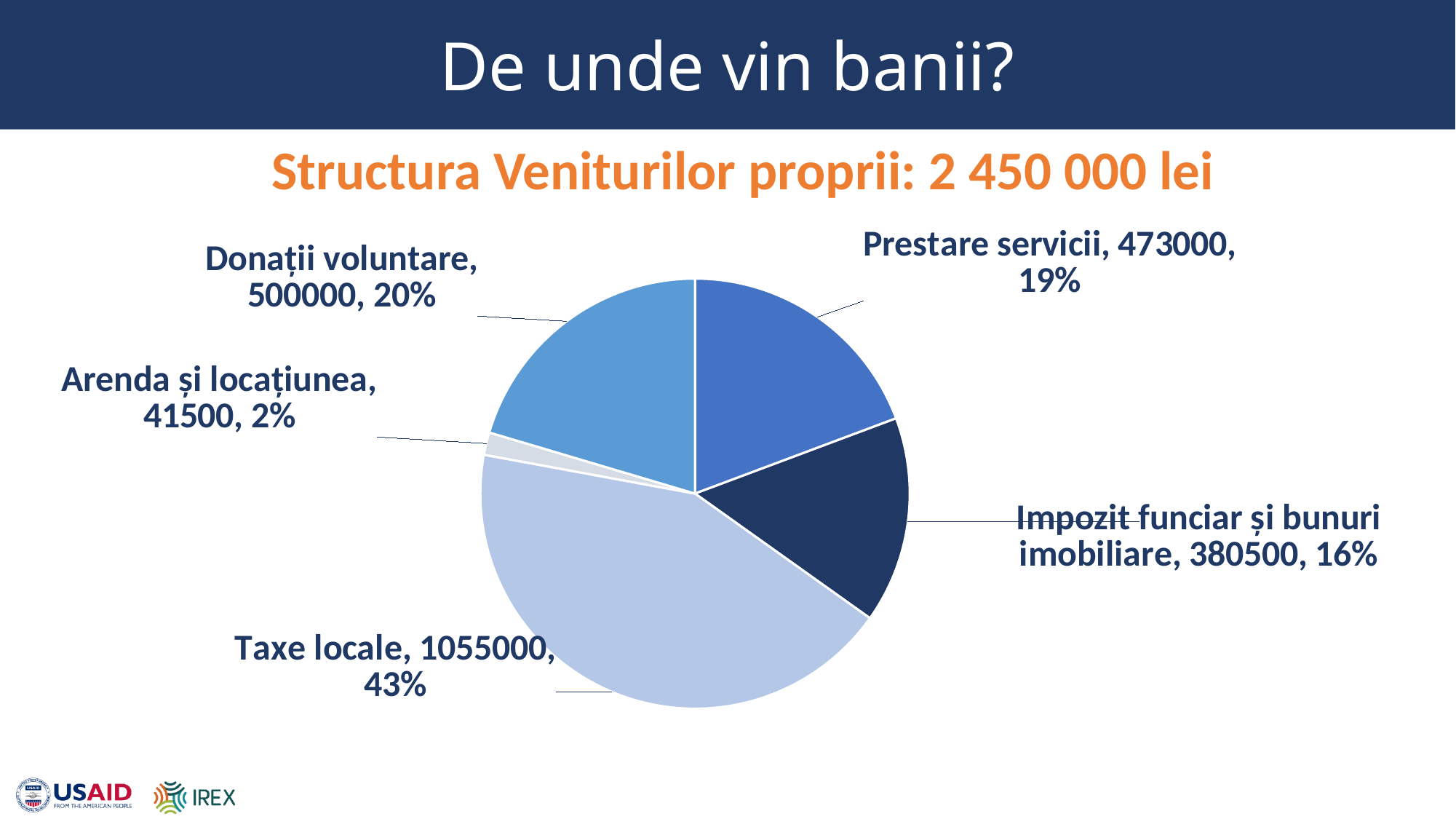
What share of the pie does Impozit funciar și bunuri imobiliare represent? 16% Which category has the smallest slice of the pie? Arenda și locațiunea Which category has the largest slice of the pie? Taxe locale What is the value for Taxe locale? 1055000 What is the value for Impozit funciar și bunuri imobiliare? 380500 What is the value for Arenda și locațiunea? 41500 What is the value for Prestare servicii? 473000 What is the difference between the values for Donații voluntare and Prestare servicii? 27000 Which is larger, the value for Prestare servicii or the value for Impozit funciar și bunuri imobiliare? Prestare servicii How many categories does the pie chart have? 5 What share of the pie does Donații voluntare represent? 20% What kind of chart is shown on the slide? pie chart